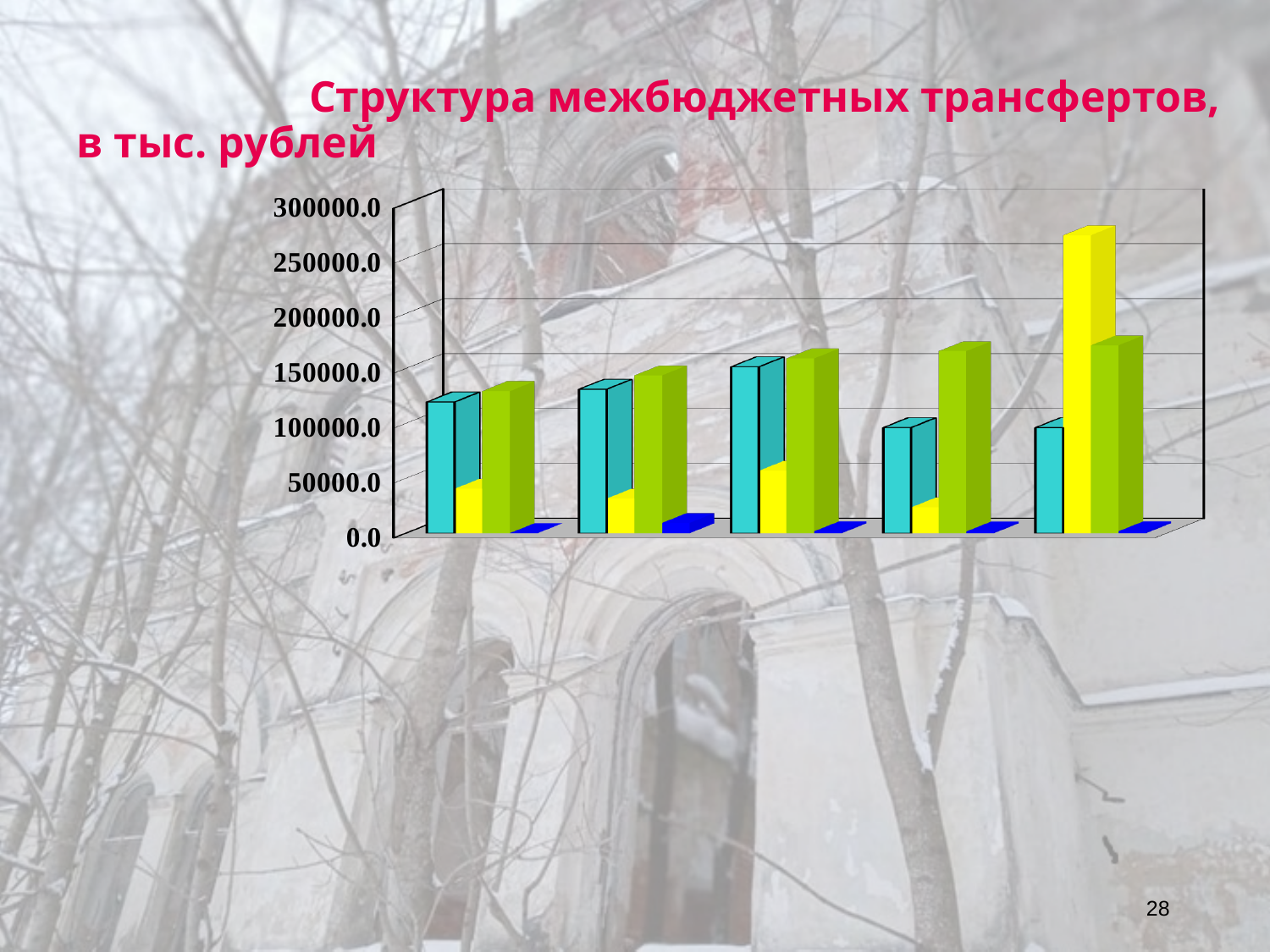
Is the green bar in the rightmost group greater or less than 150000.0? greater What is the highest value shown on the vertical axis? 300000.0 How many groups of bars are plotted along the x axis? 5 Is the yellow bar in the rightmost group greater or less than 250000.0? greater Is the cyan bar in the leftmost group greater or less than 100000.0? greater What kind of chart is shown on the slide? bar chart What is the title of the chart? Структура межбюджетных трансфертов, в тыс. рублей Do the green bars rise or fall from left to right across the groups? rise How many bars are there in each group? 4 Which group of bars contains the tallest bar on the chart? the rightmost (fifth) group